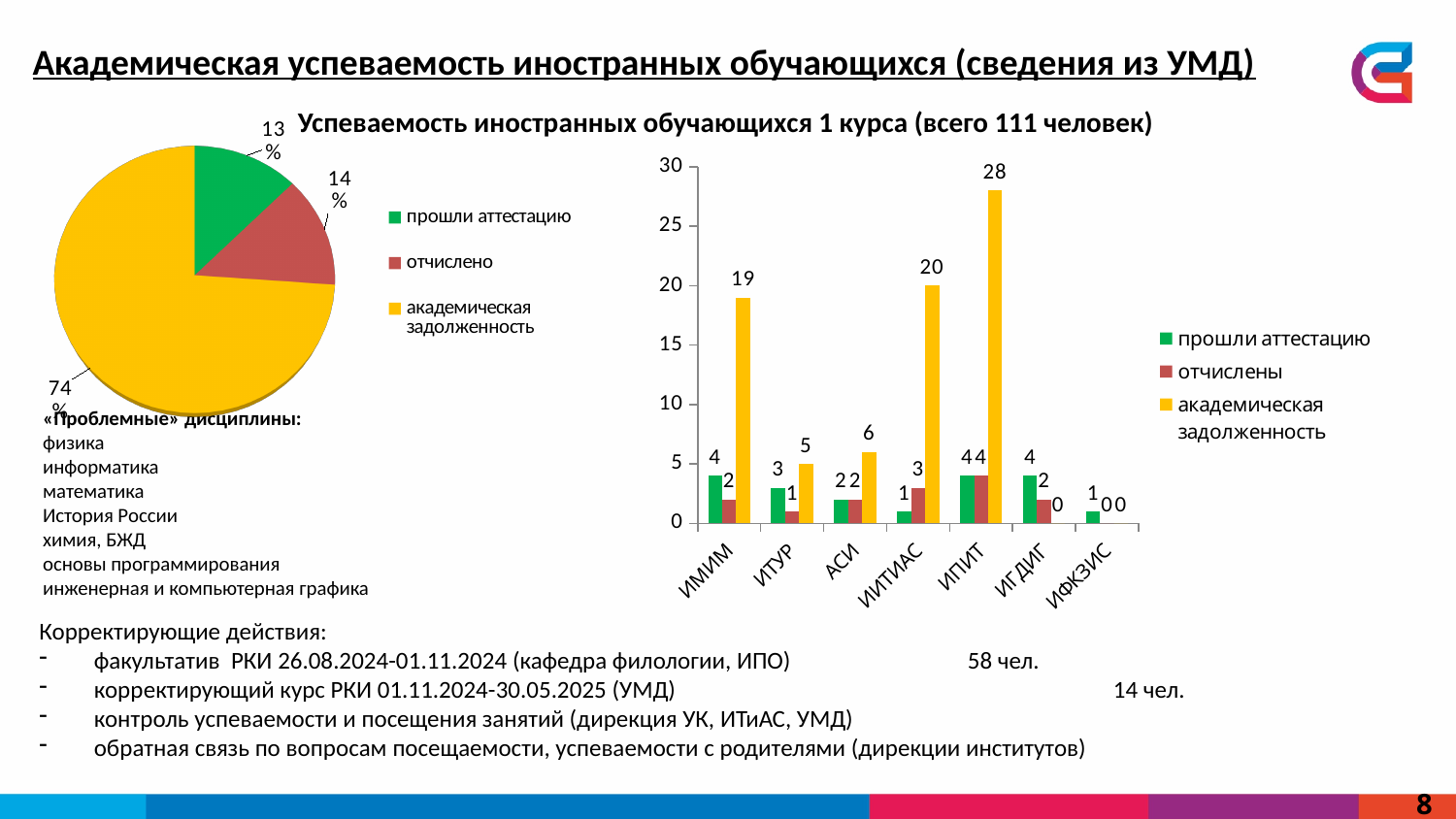
In the bar chart on the right, what is the difference between академическая задолженность for ИПИТ and for ИИТиАС? 8 What type of chart is the chart on the right? bar chart In the bar chart on the right, what is the value of академическая задолженность for ИПИТ? 28 In the pie chart on the left, which slice is the smallest? прошли аттестацию In the bar chart on the right, how many series does the legend list? 3 In the bar chart on the right, how many categories are shown on the x axis? 7 In the bar chart on the right, which is larger: академическая задолженность for ИМИМ or for АСИ? ИМИМ In the bar chart on the right, what is the value of отчислены for ИИТиАС? 3 In the bar chart on the right, what is the value of прошли аттестацию for ИМИМ? 4 In the bar chart on the right, which category has the highest value for академическая задолженность? ИПИТ What is the title of the bar chart on the right? Успеваемость иностранных обучающихся 1 курса (всего 111 человек) In the pie chart on the left, what share does академическая задолженность have? 74%